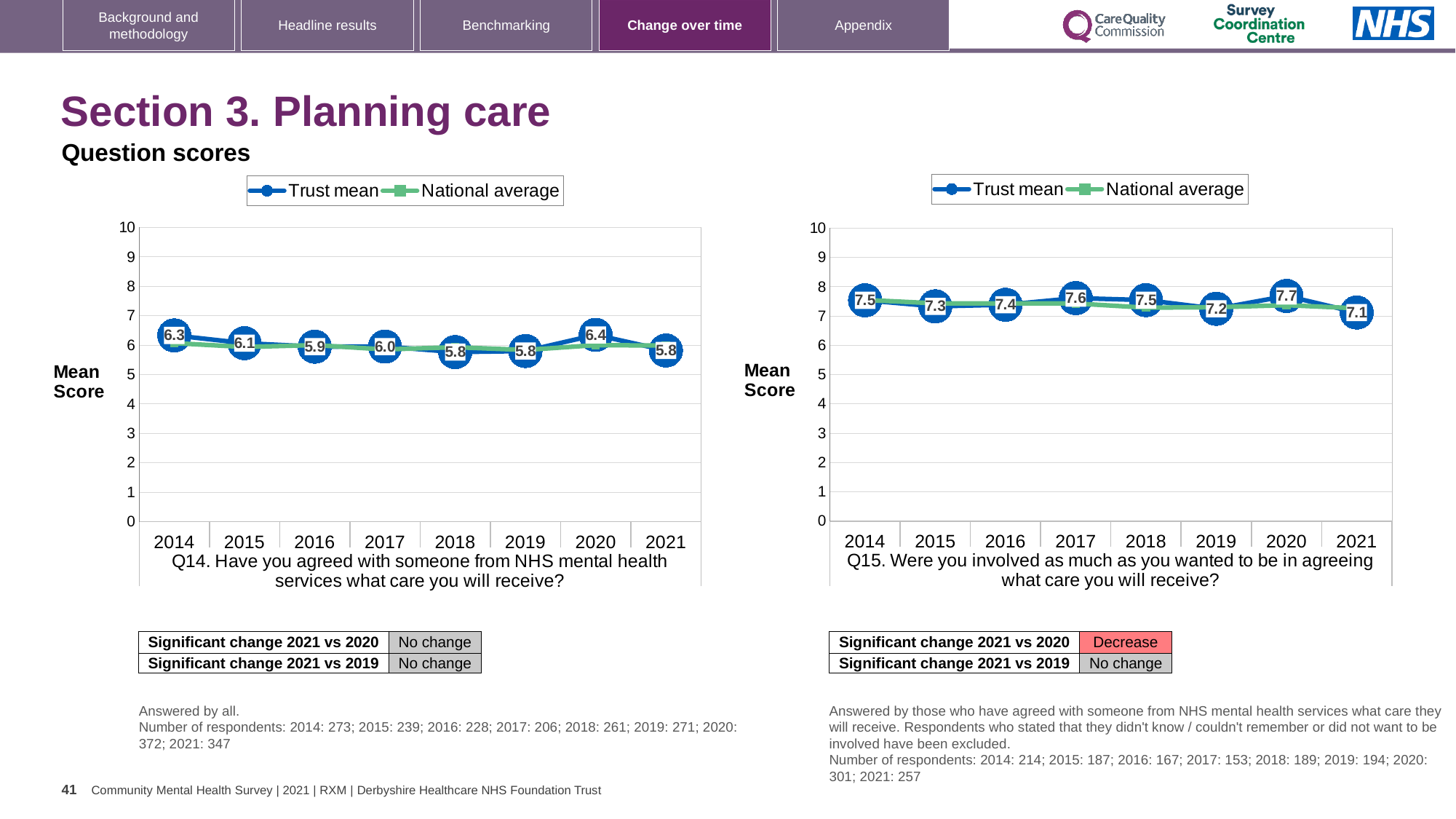
In the Q15 chart, what is the Trust mean for 2020? 7.7 In the Q14 chart, which year has the highest Trust mean? 2020 What type of chart is used for Q14? Line chart In the Q15 chart, is the Trust mean higher in 2017 or in 2019? 2017 How many series does the legend of the Q15 chart list? 2 In the Q15 chart, is the Trust mean for 2014 greater or less than 7? greater In the Q15 chart, which year has the lowest Trust mean? 2021 In the Q14 chart, what is the Trust mean for 2021? 5.8 In the Q14 chart, how many years are plotted on the x axis? 8 In the Q15 chart, what is the Trust mean for 2021? 7.1 In the Q14 chart, what is the difference between the Trust mean in 2020 and in 2021? 0.6 In the Q14 chart, what is the Trust mean for 2014? 6.3